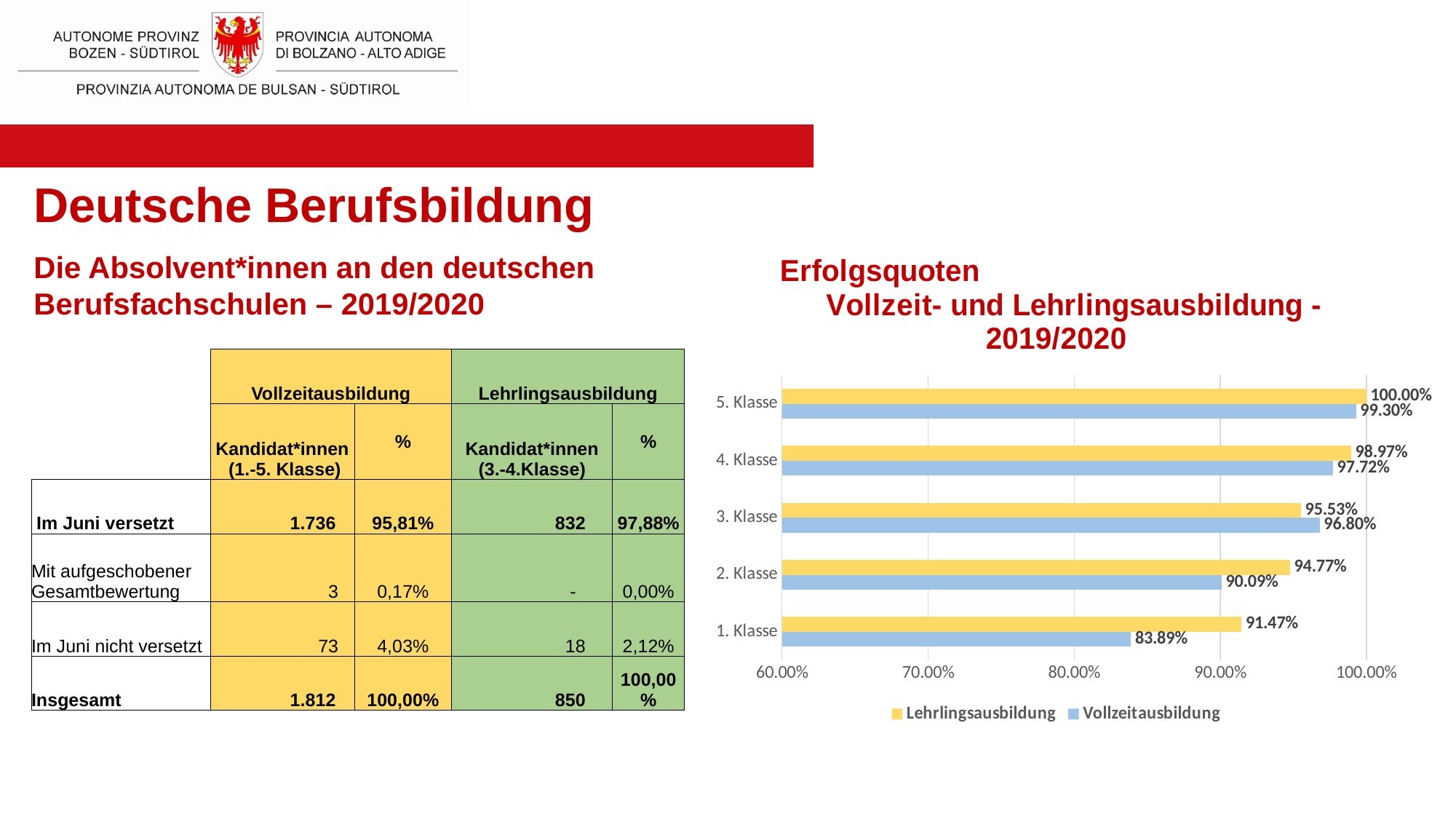
Which class has the highest Lehrlingsausbildung value? 5. Klasse What is the Lehrlingsausbildung value for 1. Klasse? 91.47% Is the Vollzeitausbildung value for 1. Klasse greater or less than 90.00%? less For 3. Klasse, which is larger: Lehrlingsausbildung or Vollzeitausbildung? Vollzeitausbildung How many series does the legend list? 2 Which class has the lowest Vollzeitausbildung value? 1. Klasse What is the difference between the Lehrlingsausbildung and Vollzeitausbildung values for 1. Klasse? 7.58% Which colour represents Lehrlingsausbildung in the chart? yellow What is the Vollzeitausbildung value for 5. Klasse? 99.30% How many classes are shown on the chart? 5 What is the Vollzeitausbildung value for 2. Klasse? 90.09% What type of chart is shown on the slide? bar chart